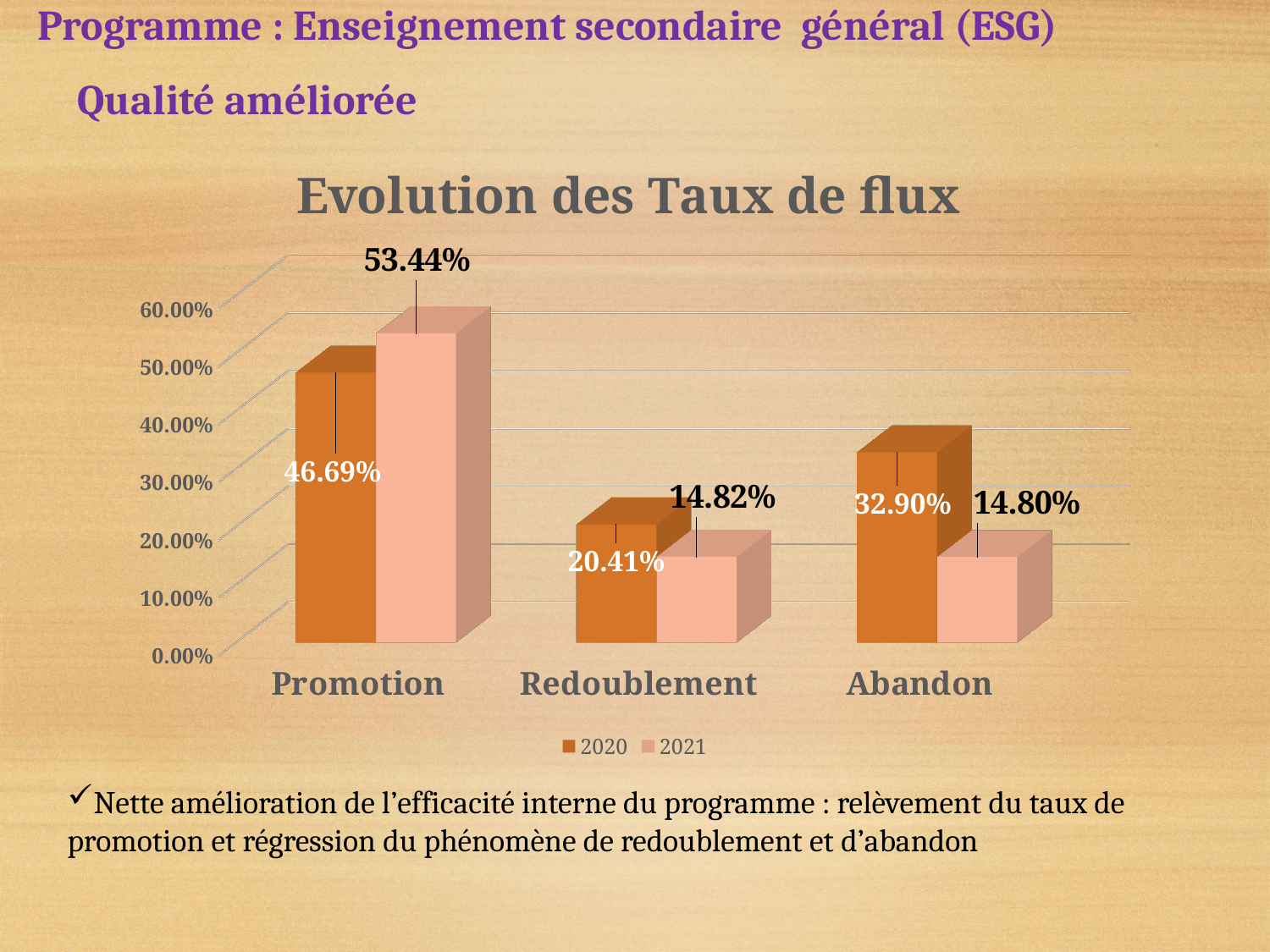
What is the difference between the 2021 and 2020 values for Promotion? 6.75 percentage points How many series does the legend list? 2 What is the value for Promotion in the 2021 series? 53.44% How many categories are shown on the x axis? 3 What kind of chart is shown on the slide? Bar chart Which is larger for Abandon, the 2020 value or the 2021 value? 2020 What is the difference between the 2020 and 2021 values for Abandon? 18.10 percentage points What is the value for Promotion in the 2020 series? 46.69% What is the value for Redoublement in the 2020 series? 20.41% Which category has the highest value in the 2020 series? Promotion What is the value for Abandon in the 2021 series? 14.80% Which category has the lowest value in the 2020 series? Redoublement